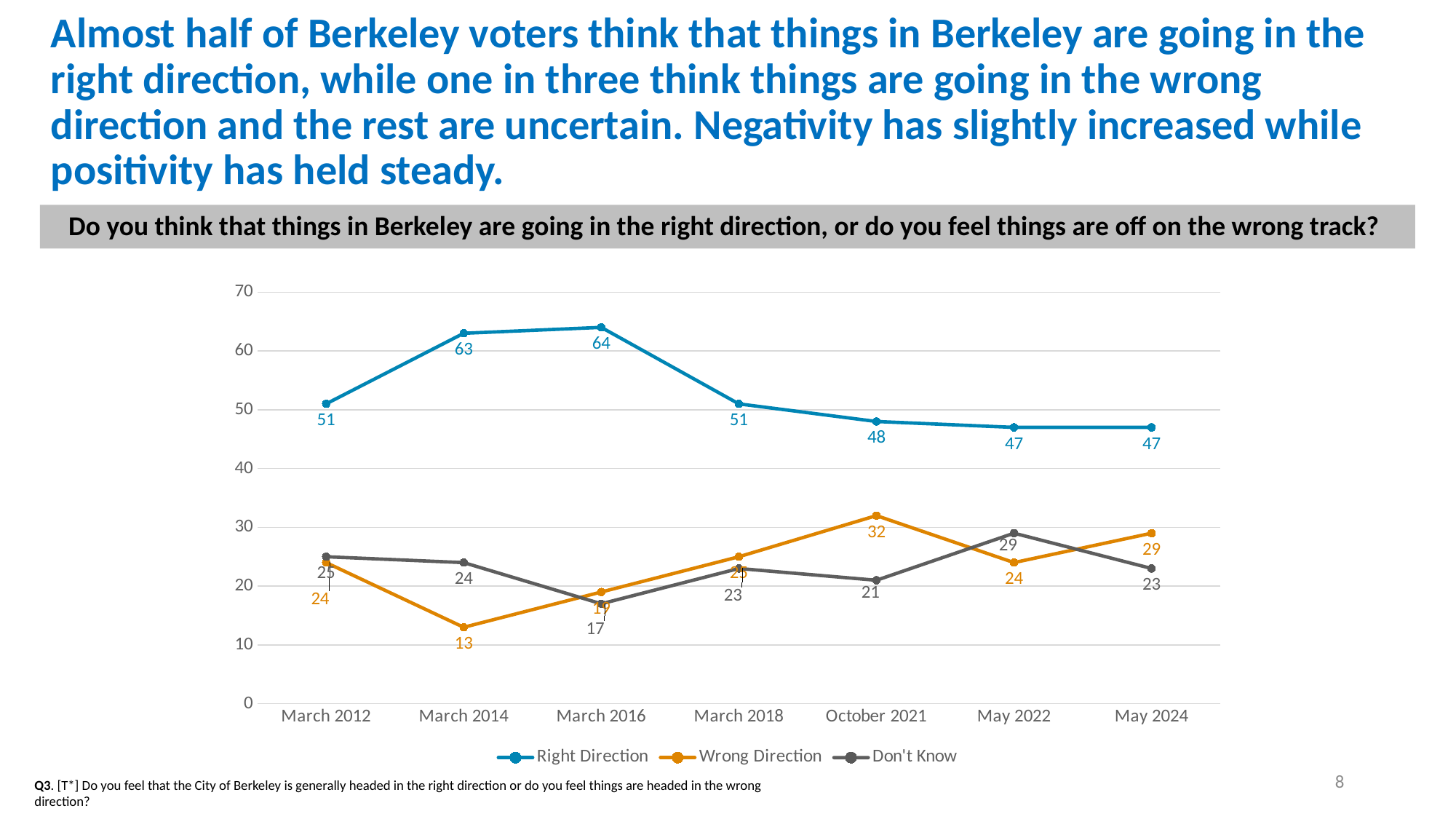
In which survey date does the Right Direction series reach its highest value? March 2016 What is the Don't Know value for May 2022? 29 What is the difference between the Right Direction value in March 2016 and in May 2024? 17 In May 2022, which is larger: Wrong Direction or Don't Know? Don't Know How many series does the chart's legend list? 3 Does the Right Direction series rise or fall from March 2016 to May 2024? Fall What colour is the Right Direction line in the chart? Blue What kind of chart is shown on the slide? Line chart In which survey date is the Wrong Direction value lowest? March 2014 What is the Right Direction value for March 2016? 64 How many survey dates are plotted along the x axis? 7 What is the Wrong Direction value for October 2021? 32